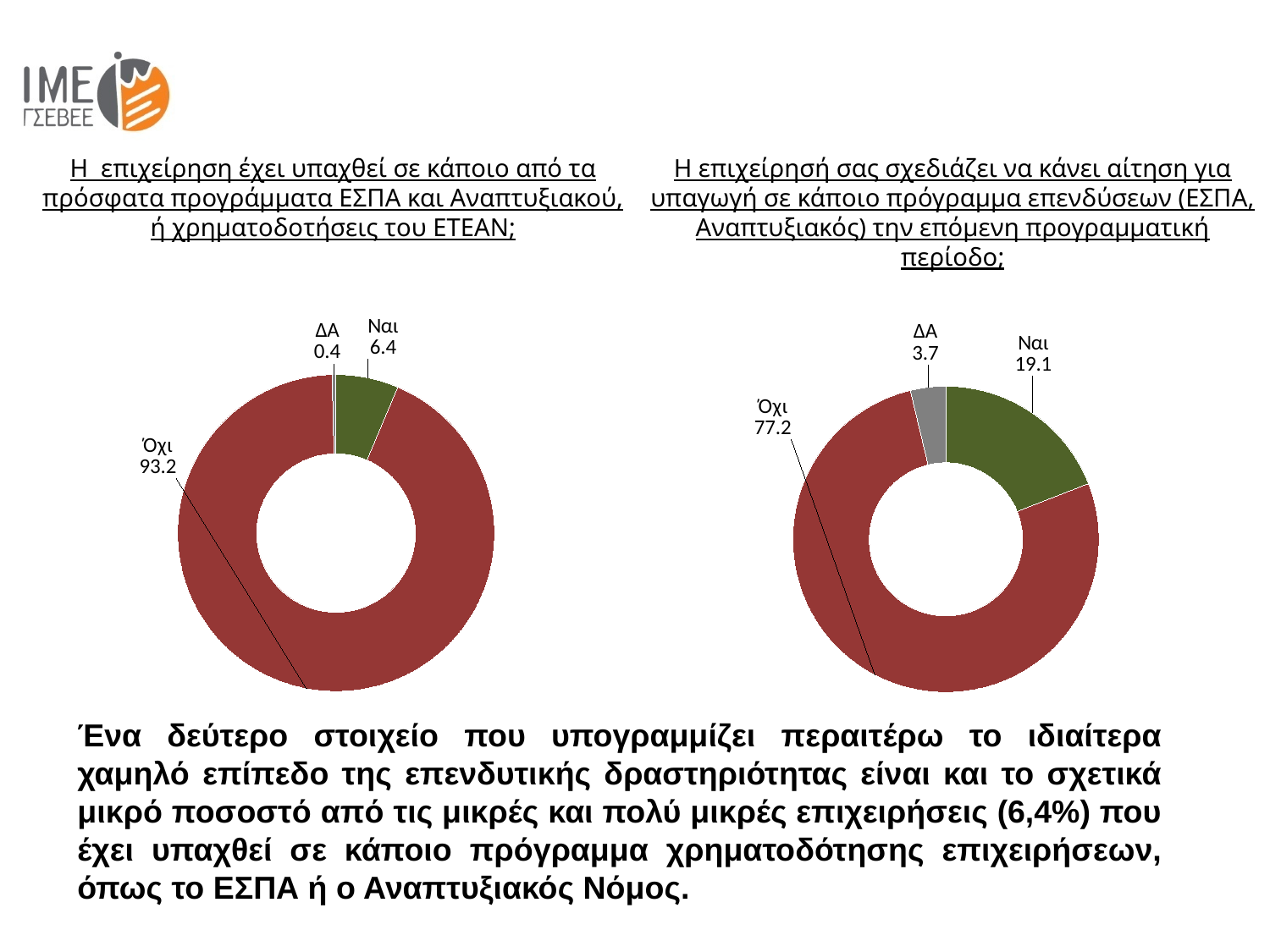
In the right chart, what is the value for Ναι? 19.1 In the left chart, which category has the largest value? Όχι In the left chart, what is the value for Όχι? 93.2 In the left chart, what is the value for Ναι? 6.4 What type of chart is the right chart? Doughnut chart In the right chart, what is the value for ΔΑ? 3.7 In the right chart, what is the difference between the values for Όχι and Ναι? 58.1 How many categories does the left chart show? 3 In the right chart, what colour is the Όχι segment? Red In the left chart, what is the difference between the values for Ναι and ΔΑ? 6.0 Which is larger: the value for Ναι in the left chart or the value for Ναι in the right chart? Ναι in the right chart In the right chart, which category has the smallest value? ΔΑ